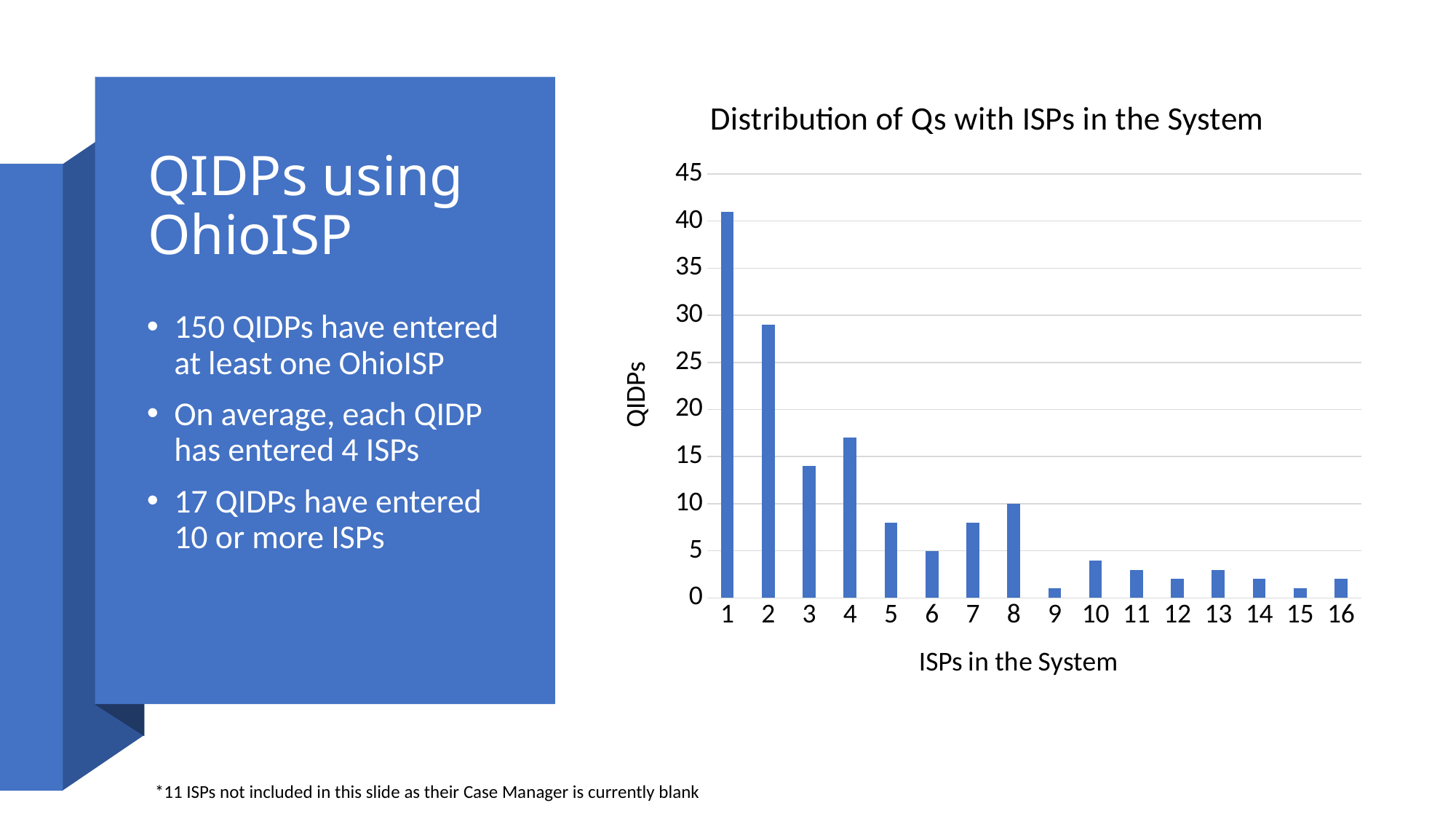
What is the label of the vertical axis of the chart? QIDPs Which has more QIDPs: 2 ISPs in the System or 3 ISPs in the System? 2 What is the title of the chart? Distribution of Qs with ISPs in the System Is the value for 2 ISPs in the System greater or less than 30? less Is the value for 1 ISP in the System greater or less than 35? greater How many categories (ISPs in the System) are shown on the x axis of the chart? 16 Which number of ISPs in the System has the highest number of QIDPs? 1 What kind of chart is shown on the slide? bar chart Is the value for 3 ISPs in the System greater or less than 15? less Which has more QIDPs: 3 ISPs in the System or 4 ISPs in the System? 4 Overall, do the number of QIDPs rise or fall as the number of ISPs in the System increases along the x axis? fall